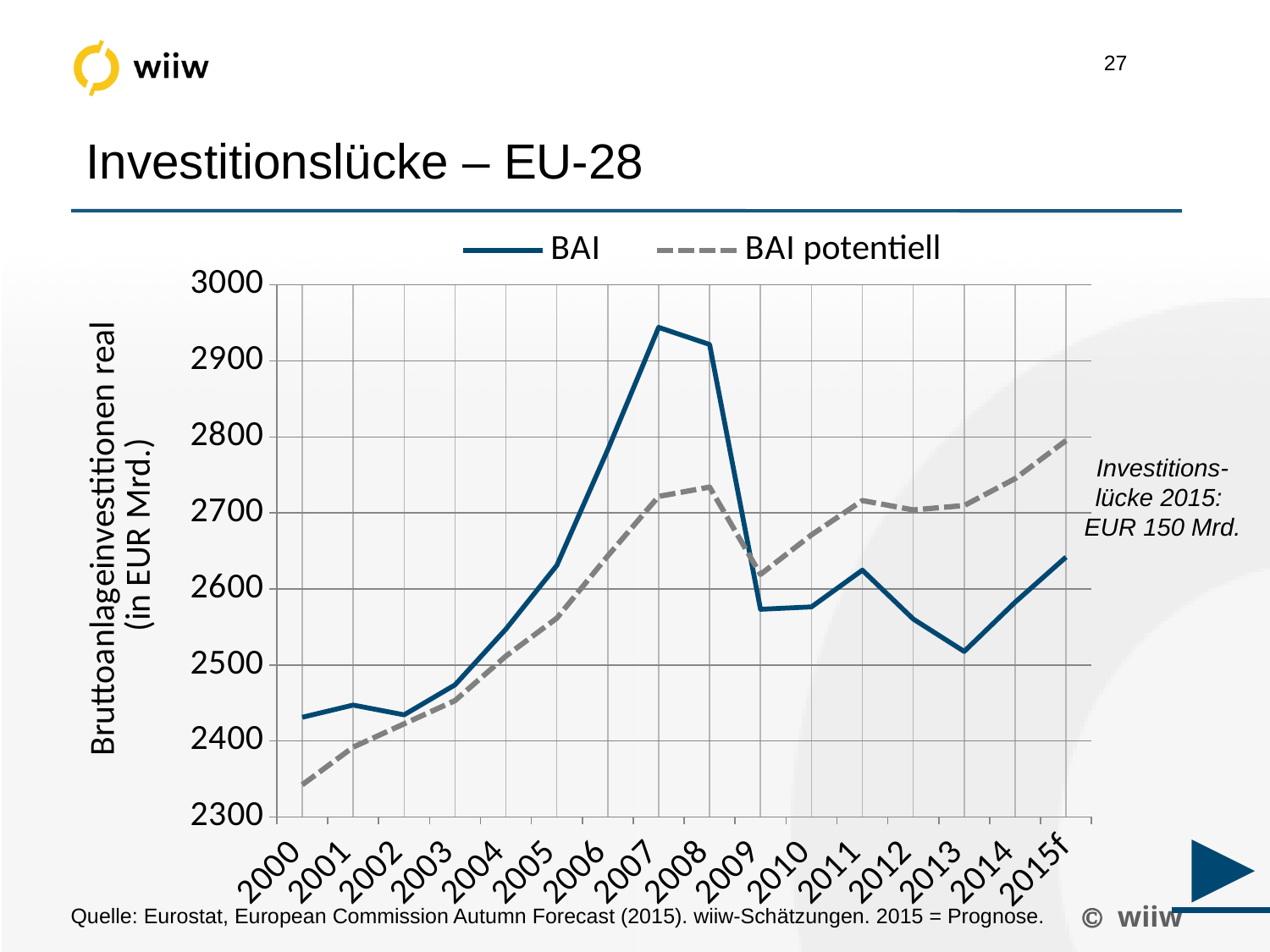
Does the BAI potentiell series rise or fall between 2009 and 2015f? rise In 2013, which series has the higher value, BAI or BAI potentiell? BAI potentiell According to the annotation on the slide, how large is the Investitionslücke in 2015? EUR 150 Mrd. Is the value for BAI in 2009 greater or less than 2600? less Is the value for BAI potentiell in 2000 greater or less than 2400? less What kind of chart is shown on the slide? line chart In which year is the BAI potentiell series at its lowest? 2000 In 2007, which series has the higher value, BAI or BAI potentiell? BAI How many years are plotted along the x axis? 16 In which year does the BAI series reach its highest value? 2007 Is the value for BAI in 2007 greater or less than 2900? greater How many series does the legend list? 2